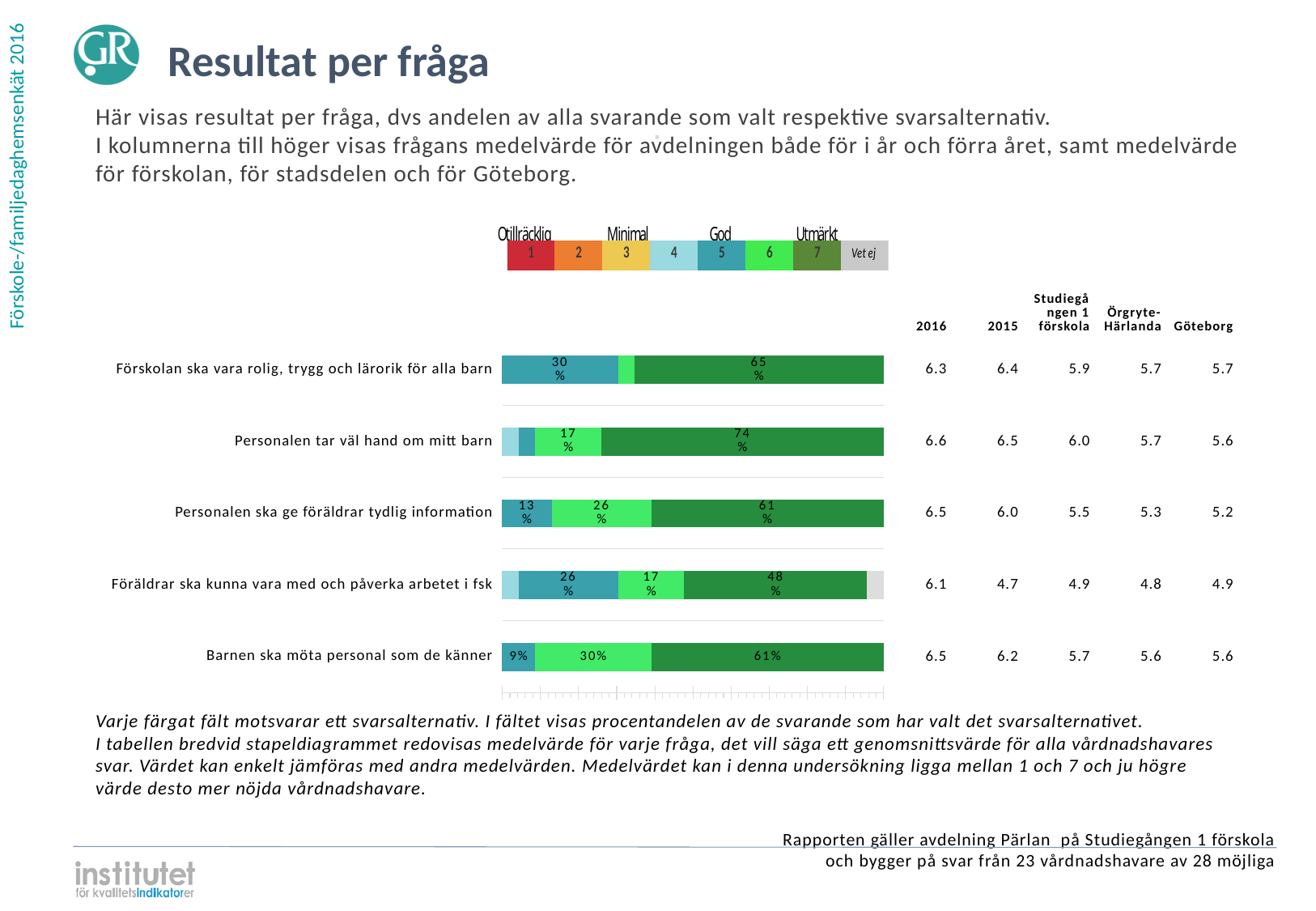
What is the difference between the 2016 and 2015 mean values for "Föräldrar ska kunna vara med och påverka arbetet i fsk"? 1.4 What is the difference in percentage points between the answer-7 share for "Personalen tar väl hand om mitt barn" and for "Föräldrar ska kunna vara med och påverka arbetet i fsk"? 26 percentage points What is the 2016 mean value for "Föräldrar ska kunna vara med och påverka arbetet i fsk"? 6.1 What percentage of respondents chose answer 7 (Utmärkt) for "Personalen tar väl hand om mitt barn"? 74% How many answer categories does the legend above the chart list? 8 What is the Göteborg mean value for "Personalen ska ge föräldrar tydlig information"? 5.2 Which question has the lowest share of respondents choosing answer 7 (dark green)? Föräldrar ska kunna vara med och påverka arbetet i fsk Which question has the highest share of respondents choosing answer 7 (dark green)? Personalen tar väl hand om mitt barn What percentage of respondents chose answer 5 for "Förskolan ska vara rolig, trygg och lärorik för alla barn"? 30% What kind of chart is used to show the results per question? Stacked bar chart How many questions (bars) are shown in the chart? 5 Which is larger: the answer-6 share for "Barnen ska möta personal som de känner" or the answer-6 share for "Personalen ska ge föräldrar tydlig information"? Barnen ska möta personal som de känner (30%)